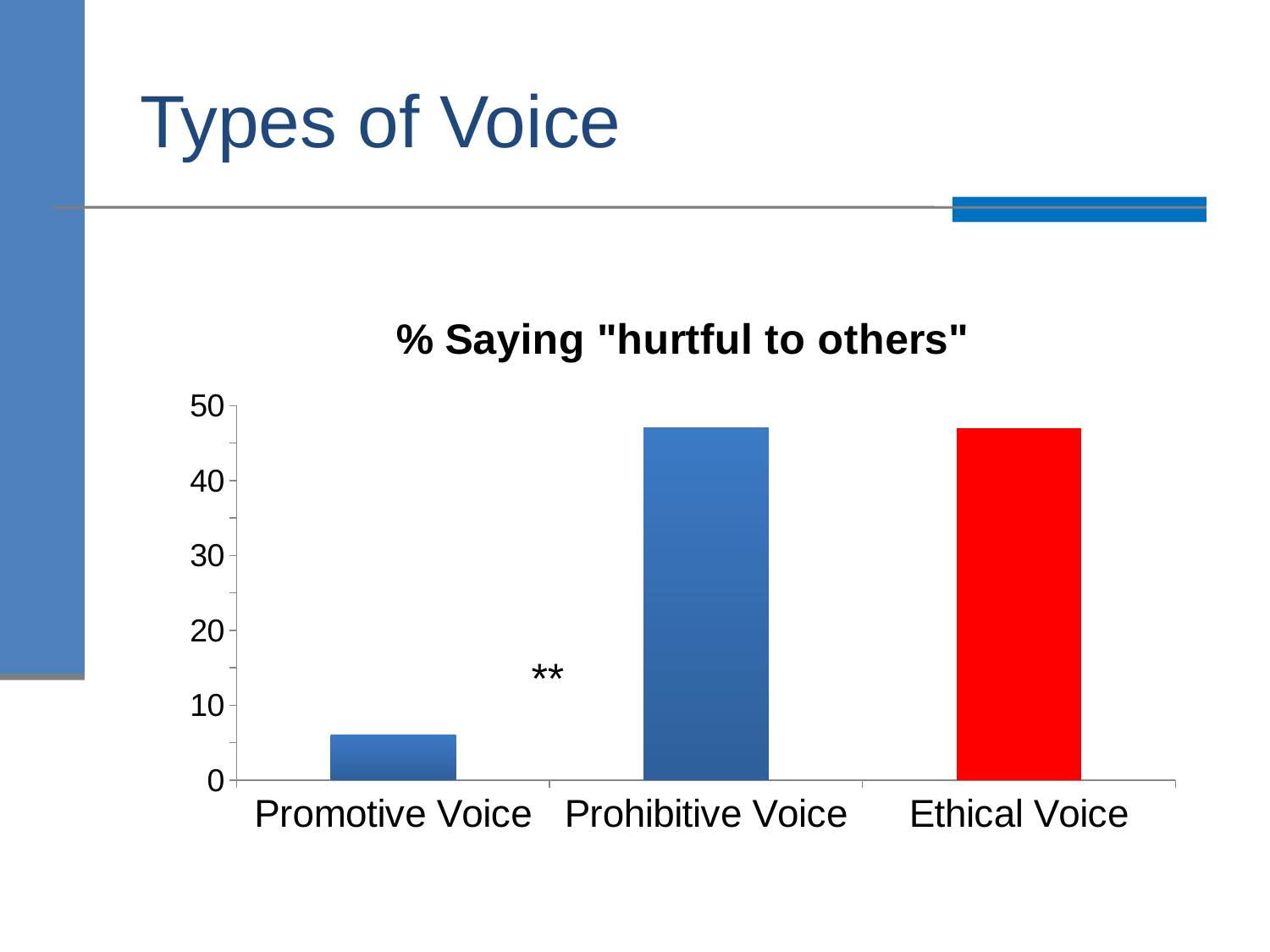
What is the highest value shown on the y axis of the chart? 50 What colour is the bar for Ethical Voice? red Is the value for Promotive Voice greater or less than 10? less Is the value for Prohibitive Voice greater or less than 50? less What kind of chart is shown on the slide? bar chart Is the value for Prohibitive Voice greater or less than 40? greater How many categories are shown on the x axis of the chart? 3 Which is larger, the value for Ethical Voice or the value for Promotive Voice? Ethical Voice Which is larger, the value for Promotive Voice or the value for Prohibitive Voice? Prohibitive Voice What is the title of the chart? % Saying "hurtful to others" Which category has the lowest value in the chart? Promotive Voice